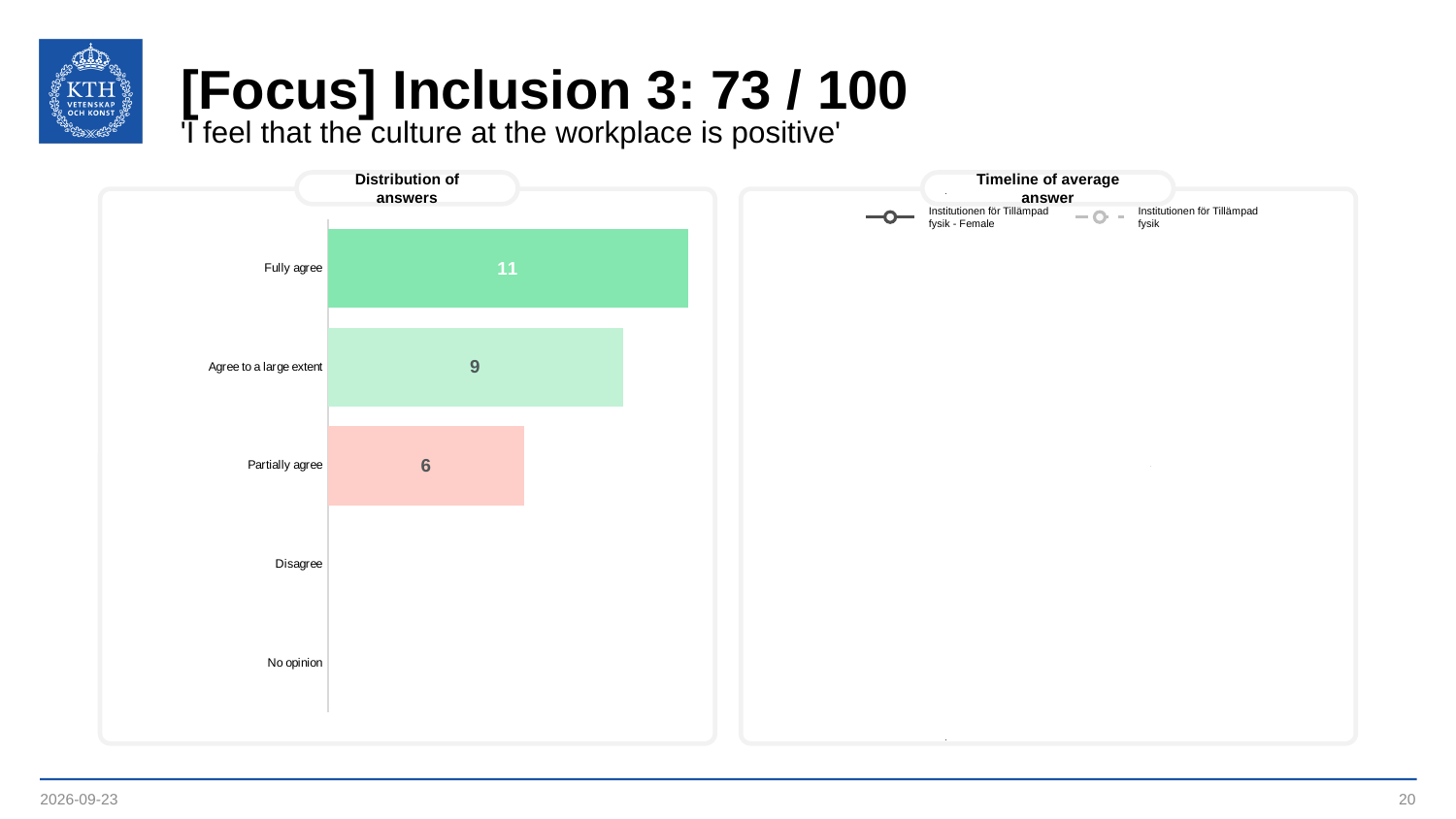
In the 'Distribution of answers' chart, what is the value for 'Fully agree'? 11 How many categories are listed on the axis of the 'Distribution of answers' chart? 5 What kind of chart is the 'Distribution of answers' chart? Bar chart What is the title of the chart on the left of the slide? Distribution of answers In the 'Distribution of answers' chart, which category has the highest value? Fully agree In the 'Distribution of answers' chart, what is the value for 'Partially agree'? 6 In the 'Distribution of answers' chart, what is the total of the three labelled bars? 26 How many series does the legend of the 'Timeline of average answer' chart list? 2 In the 'Distribution of answers' chart, what is the difference between 'Fully agree' and 'Agree to a large extent'? 2 In the 'Distribution of answers' chart, what is the value for 'Agree to a large extent'? 9 In the 'Distribution of answers' chart, which is larger: 'Agree to a large extent' or 'Partially agree'? Agree to a large extent In the 'Distribution of answers' chart, what is the difference between 'Fully agree' and 'Partially agree'? 5